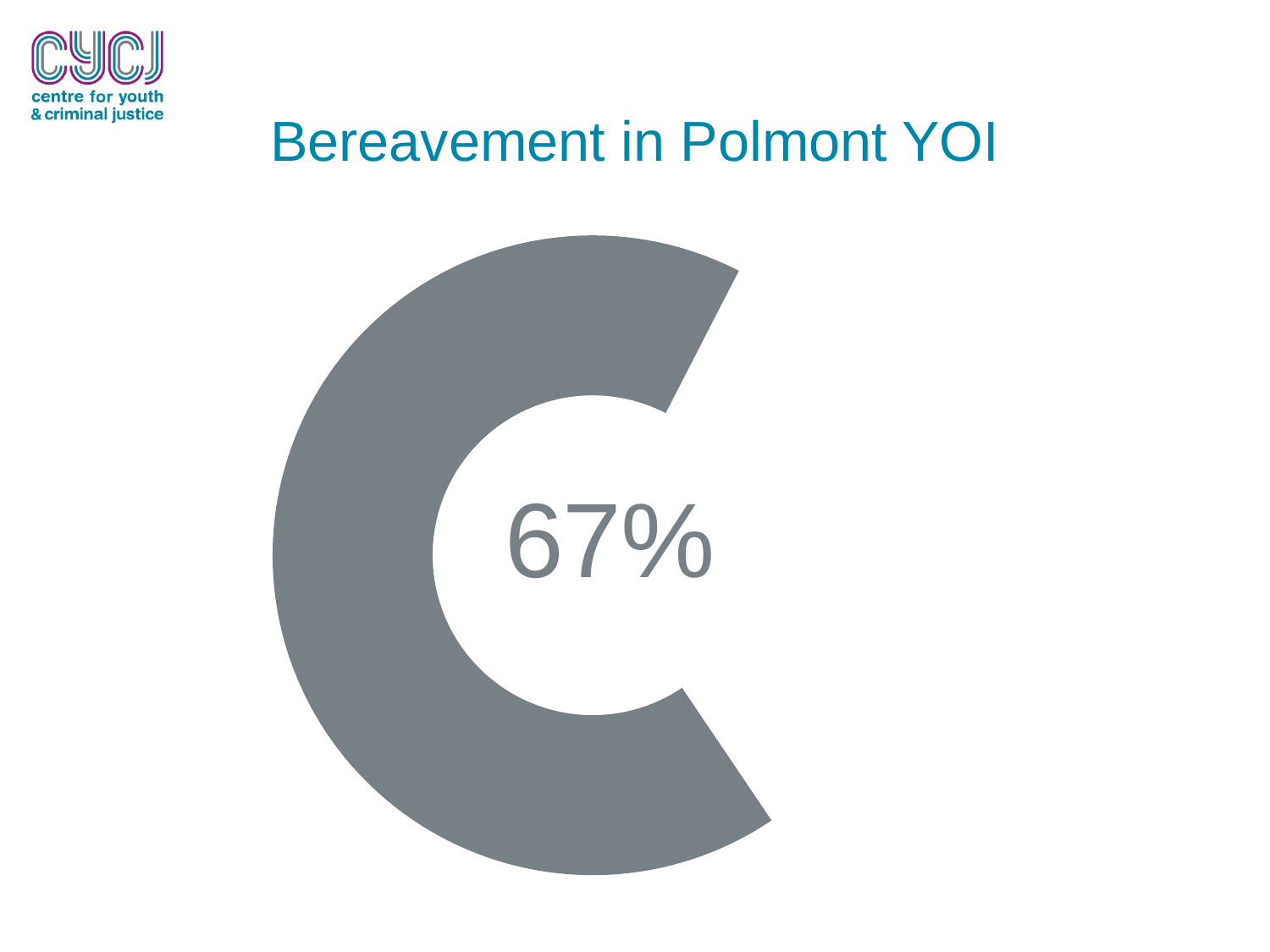
Is the value shown on the doughnut chart greater or less than 75%? less What percentage is printed in the centre of the doughnut chart? 67% What share of the whole does the grey segment of the doughnut chart represent? 67% What colour is the filled segment of the doughnut chart? Grey What is the title of the slide containing the doughnut chart? Bereavement in Polmont YOI What kind of chart is shown on the slide? Doughnut chart How many filled segments are visible on the doughnut chart? 1 Is the value shown on the doughnut chart greater or less than 50%? greater